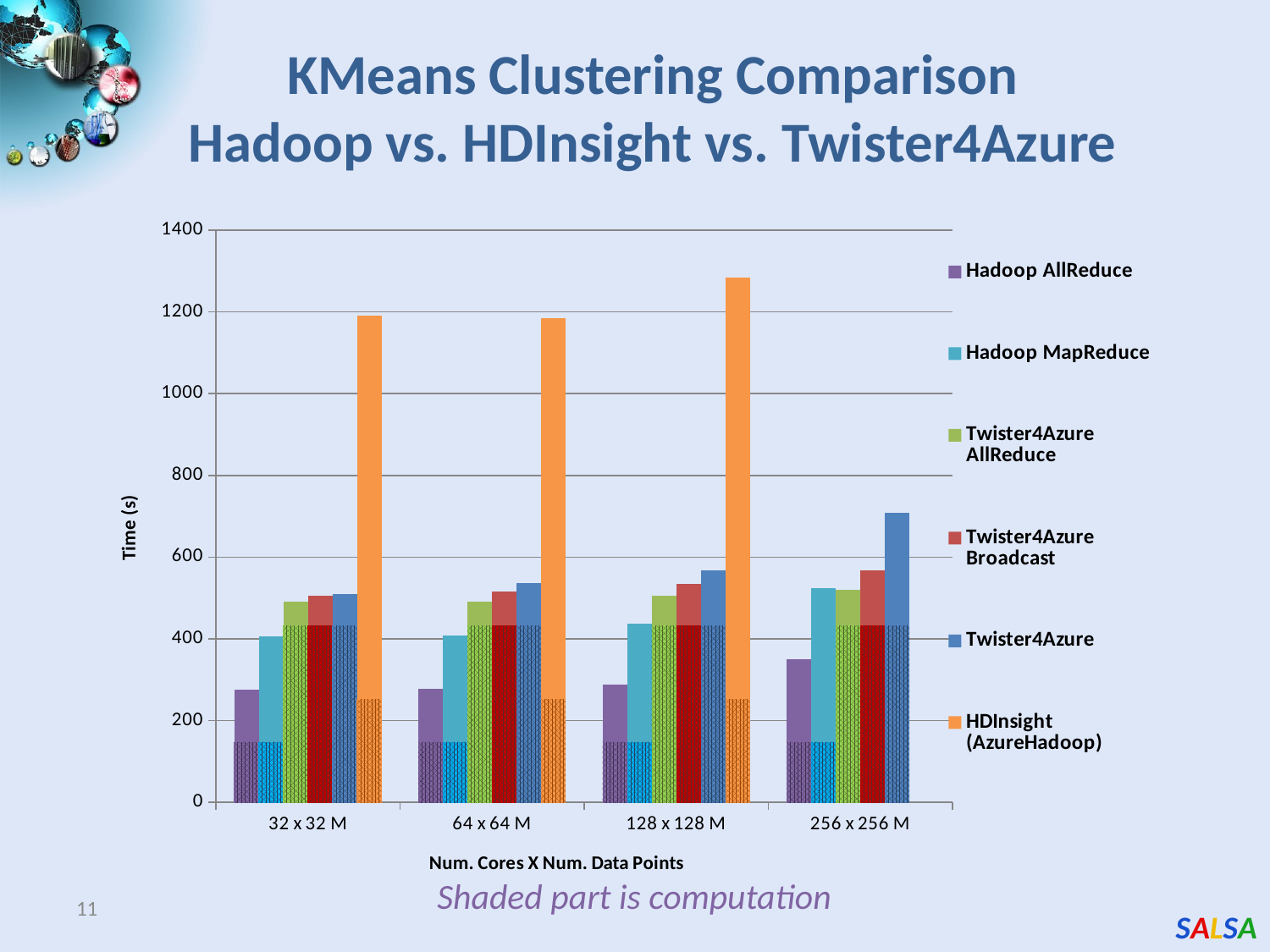
For which category is the HDInsight (AzureHadoop) bar the tallest? 128 x 128 M Which series has the lowest value for the 256 x 256 M category? Hadoop AllReduce Is the value for Hadoop AllReduce at 32 x 32 M greater or less than 400? less Which series has the highest value for the 32 x 32 M category? HDInsight (AzureHadoop) Is the value for HDInsight (AzureHadoop) at 128 x 128 M greater or less than 1200? greater What is the label of the chart's y axis? Time (s) At 256 x 256 M, which is larger: Twister4Azure or Hadoop MapReduce? Twister4Azure What kind of chart is shown on the slide? bar chart Is the value for Twister4Azure at 256 x 256 M greater or less than 600? greater How many series does the chart's legend list? 6 Do the values for the Twister4Azure series rise or fall from 32 x 32 M to 256 x 256 M? rise How many categories are shown on the x axis of the chart? 4